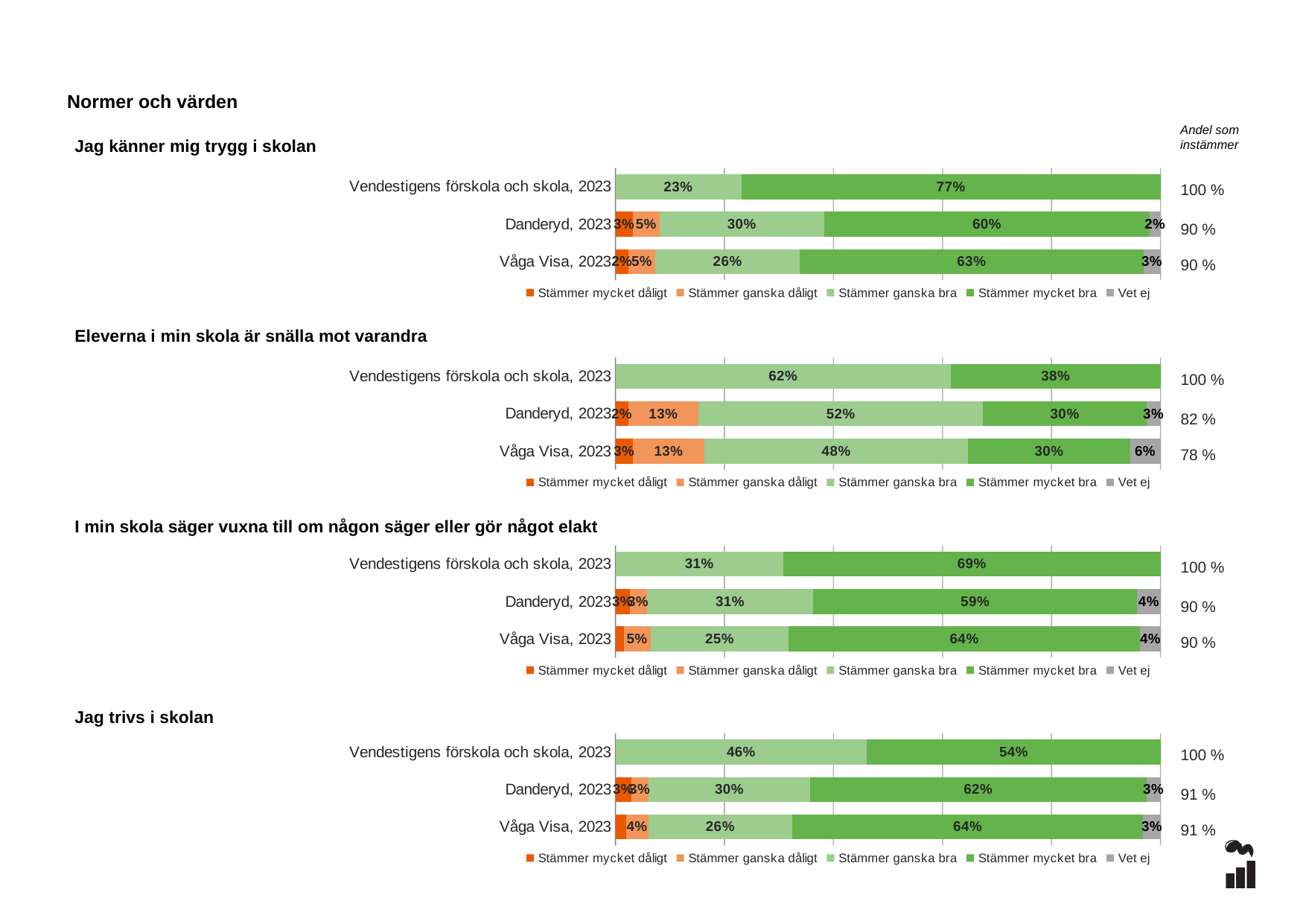
In the chart 'Jag trivs i skolan', what is the 'Stämmer ganska bra' value for Vendestigens förskola och skola, 2023? 46% In the chart 'Jag trivs i skolan', what is the 'Vet ej' value for Våga Visa, 2023? 3% What is the 'Andel som instämmer' shown for Våga Visa, 2023 in the chart 'Eleverna i min skola är snälla mot varandra'? 78 % What type of chart is used for 'Jag känner mig trygg i skolan'? Stacked bar chart How many series does the legend of the chart 'Jag trivs i skolan' list? 5 In the chart 'I min skola säger vuxna till om någon säger eller gör något elakt', which is larger: the 'Stämmer mycket bra' value for Vendestigens förskola och skola, 2023 or for Danderyd, 2023? Vendestigens förskola och skola, 2023 In the chart 'Jag känner mig trygg i skolan', what percentage of Vendestigens förskola och skola, 2023 answered 'Stämmer mycket bra'? 77% In the chart 'Eleverna i min skola är snälla mot varandra', what is the 'Stämmer ganska dåligt' value for Våga Visa, 2023? 13% In the chart 'Jag känner mig trygg i skolan', what is the 'Stämmer ganska bra' value for Danderyd, 2023? 30% In the chart 'I min skola säger vuxna till om någon säger eller gör något elakt', what is the 'Stämmer mycket bra' value for Våga Visa, 2023? 64% In the chart 'Eleverna i min skola är snälla mot varandra', which row has the highest 'Stämmer ganska bra' value? Vendestigens förskola och skola, 2023 In the chart 'Eleverna i min skola är snälla mot varandra', what is the difference between the 'Stämmer ganska bra' values for Danderyd, 2023 and Våga Visa, 2023? 4%